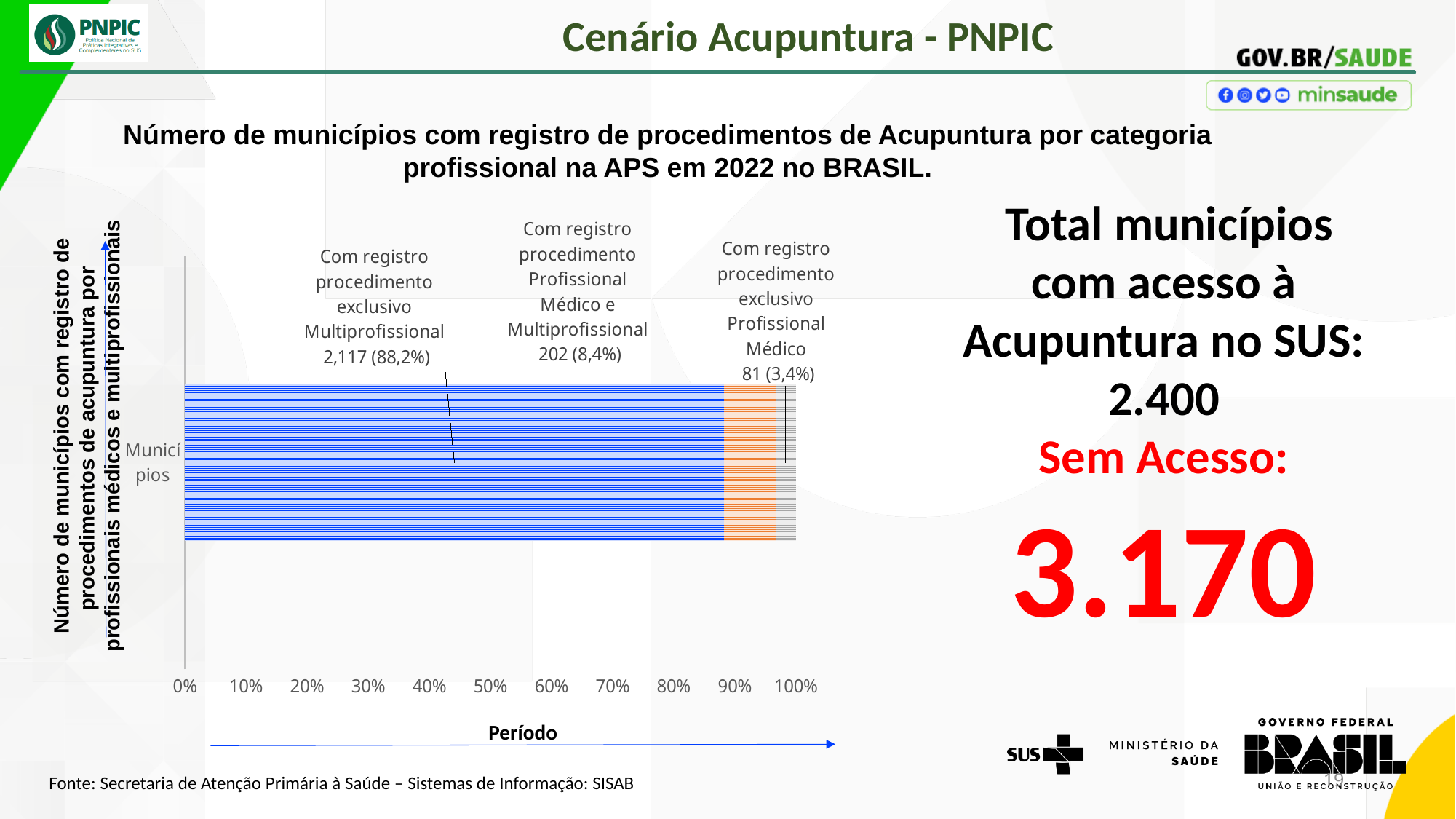
Which segment of the bar is the largest? Com registro procedimento exclusivo Multiprofissional How many categories are plotted on the vertical axis of the chart? 1 How many municipalities have records of procedures exclusively by multiprofessional staff ("Com registro procedimento exclusivo Multiprofissional")? 2,117 (88,2%) What is the total number of municipalities across the three segments of the bar (2,117 + 202 + 81)? 2,400 Is the share for "Com registro procedimento exclusivo Multiprofissional" greater or less than 80%? greater What is the difference in number of municipalities between the exclusive multiprofessional segment (2,117) and the medical and multiprofessional segment (202)? 1,915 What kind of chart is shown on the slide? bar chart What value is shown for "Com registro procedimento exclusivo Profissional Médico"? 81 (3,4%) What is the label of the horizontal axis below the chart? Período Which segment of the bar is the smallest? Com registro procedimento exclusivo Profissional Médico What value is shown for "Com registro procedimento Profissional Médico e Multiprofissional"? 202 (8,4%) Which is larger: the segment for "Profissional Médico e Multiprofissional" or the segment for "exclusivo Profissional Médico"? Profissional Médico e Multiprofissional